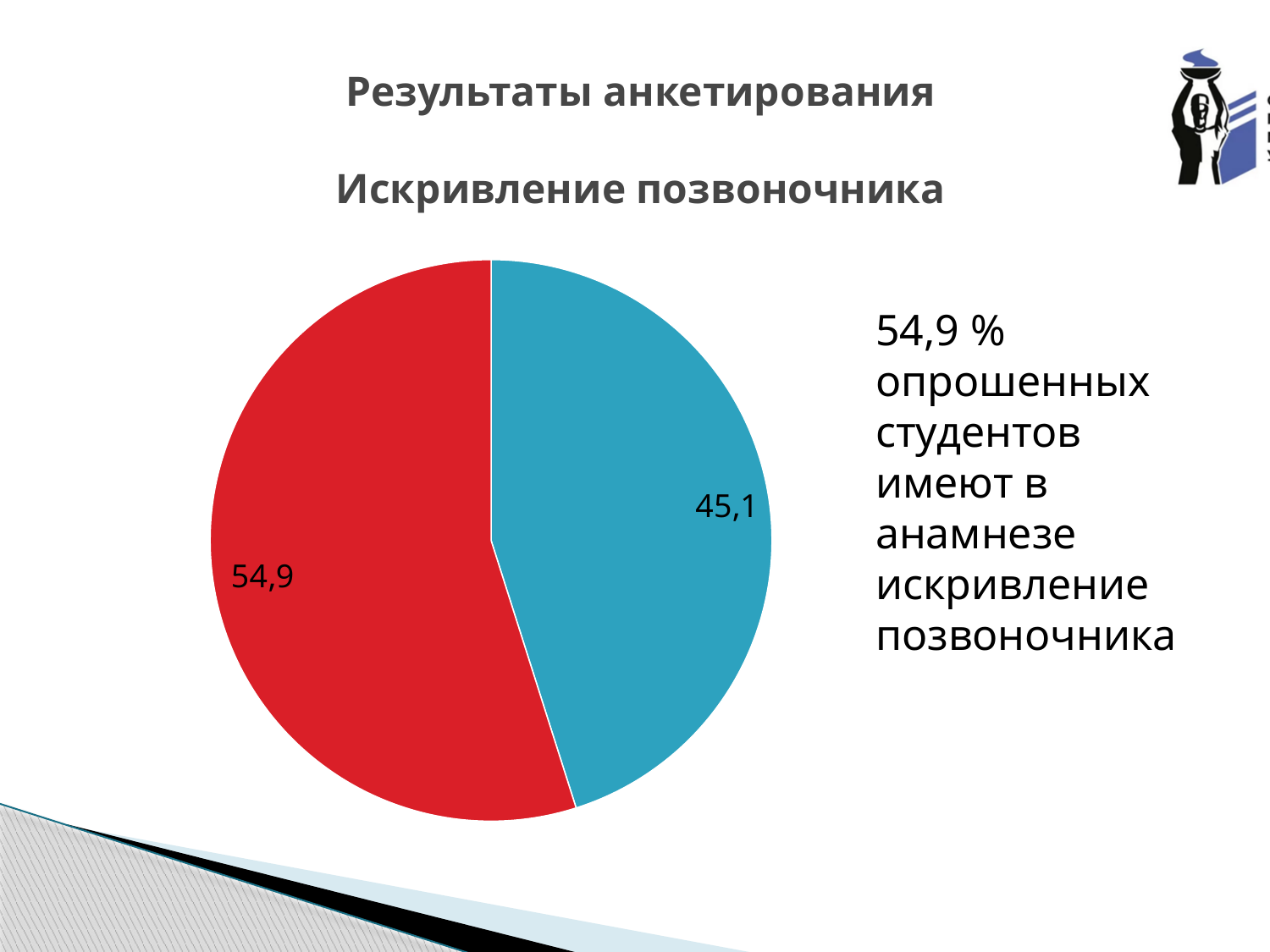
What is the title of the chart on the slide? Искривление позвоночника What kind of chart is shown on the slide? pie chart Is the value of the red slice greater or less than 50? greater According to the text next to the chart, what percentage of surveyed students have spinal curvature in their history? 54,9 % Which slice of the pie chart is the largest? the red slice (54,9) What is the difference between the values of the red slice and the blue slice? 9,8 How many slices does the pie chart have? 2 What is the total of the two slice values shown on the pie chart? 100 What value is printed on the red slice of the pie chart? 54,9 Which is larger, the red slice or the blue slice of the pie chart? the red slice What value is printed on the blue slice of the pie chart? 45,1 Which slice of the pie chart is the smallest? the blue slice (45,1)